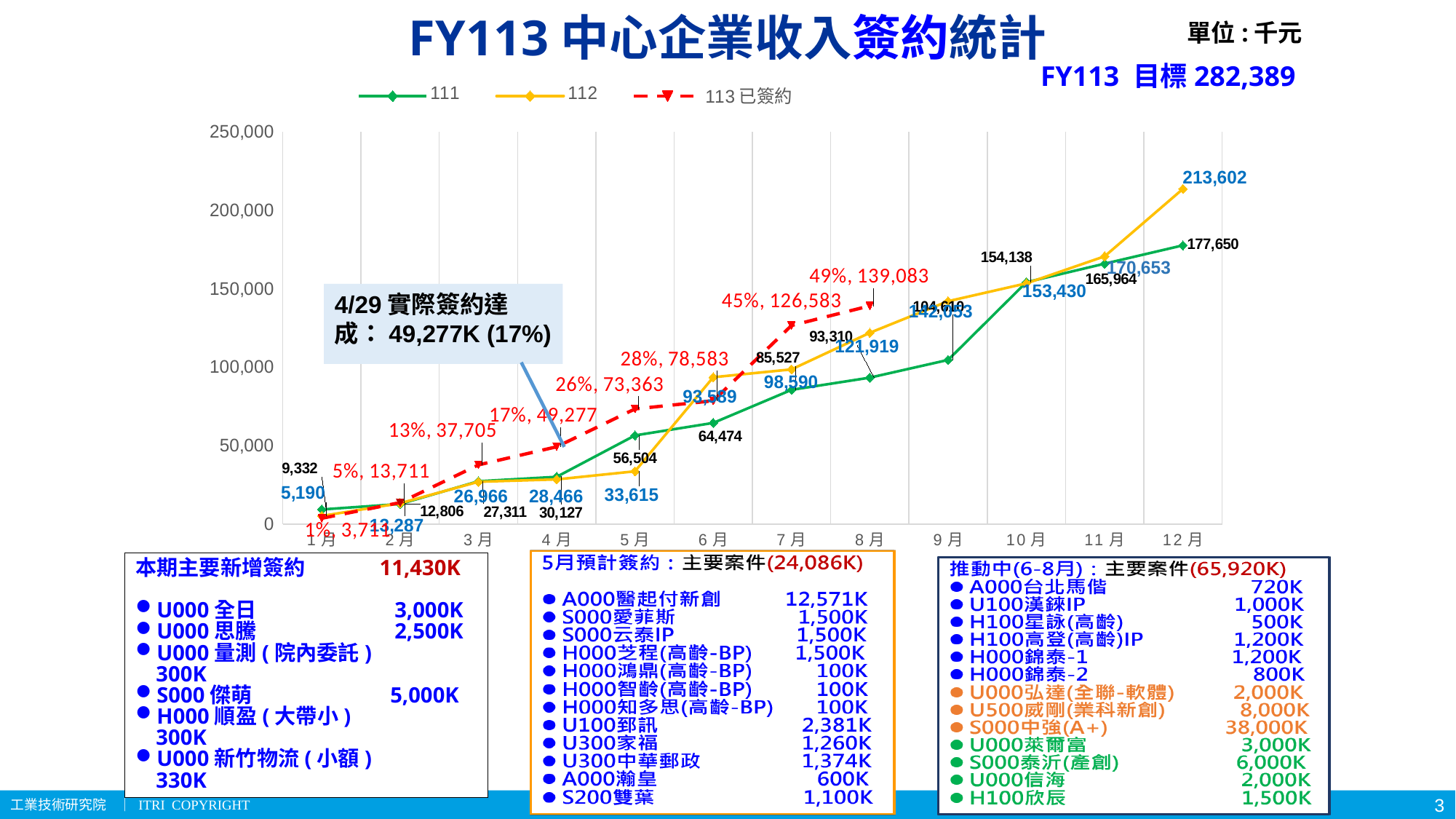
What is the value of series 112 in 12月? 213,602 What is the value of series 111 in 12月? 177,650 How many series does the chart legend list? 3 Is the value of series 112 in 12月 greater or less than 200,000? greater What kind of chart is shown on the slide? line chart What is the value of series 113 已簽約 in 8月? 139,083 Does series 111 rise or fall from 1月 to 12月? rise What is the value of series 111 in 5月? 56,504 In 10月, which series has the larger value, 111 or 112? 111 How many months are shown on the x axis of the chart? 12 What is the difference between series 112 and series 111 in 12月? 35,952 In which month does series 112 reach its highest value? 12月